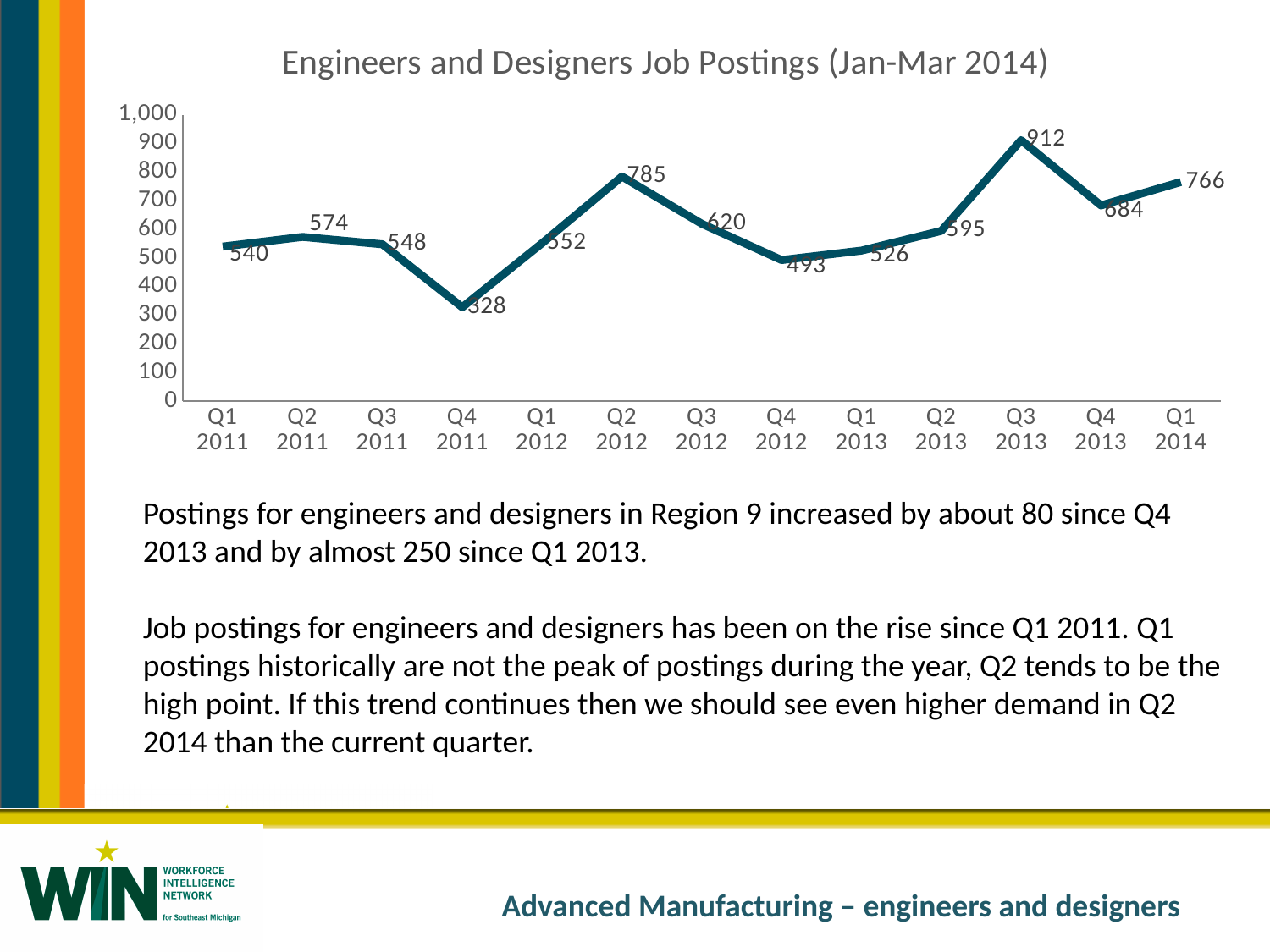
Which quarter has the lowest number of job postings? Q4 2011 Which quarter has the highest number of job postings? Q3 2013 Does the value rise or fall from Q3 2013 to Q4 2013? Fall What is the difference between the values for Q1 2014 and Q4 2013? 82 What is the title of the chart? Engineers and Designers Job Postings (Jan-Mar 2014) Which is larger, the value for Q2 2012 or the value for Q1 2014? Q2 2012 What type of chart is shown on the slide? Line chart What is the value for Q1 2014? 766 What is the value for Q4 2011? 328 How many quarters are plotted on the chart? 13 What is the value for Q3 2013? 912 Is the value for Q3 2012 greater or less than 500? greater